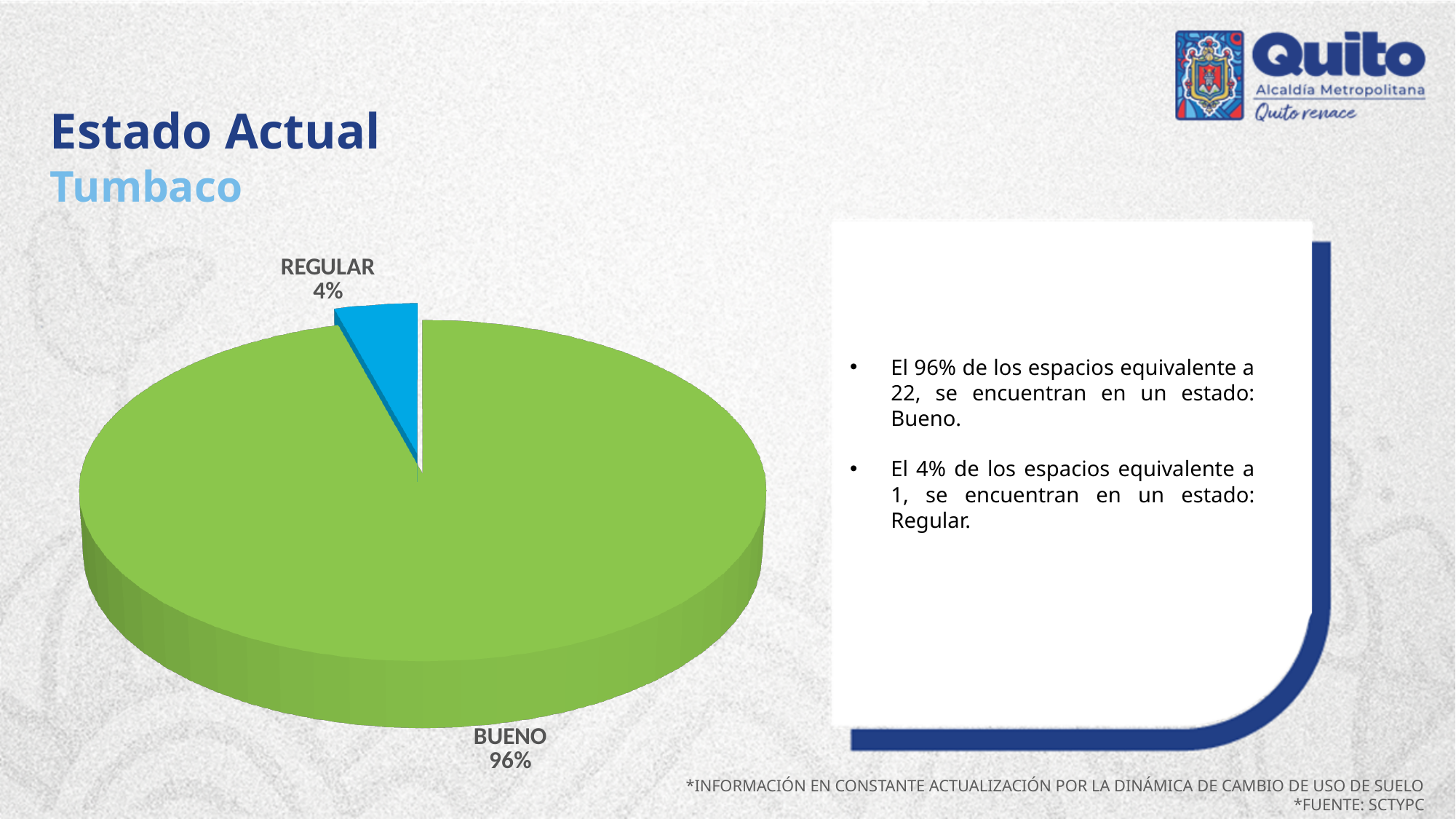
Is the share for BUENO greater or less than 50%? greater What kind of chart is shown on the slide? Pie chart Which slice is larger, BUENO or REGULAR? BUENO Which category has the largest slice of the pie? BUENO Is the share for REGULAR greater or less than 10%? less What share of the pie does REGULAR represent? 4% What share of the pie does BUENO represent? 96% Which category has the smallest slice of the pie? REGULAR How many categories are shown in the pie chart? 2 What is the difference in percentage points between the BUENO and REGULAR slices? 92 What colour is the BUENO slice? Green What colour is the REGULAR slice? Blue